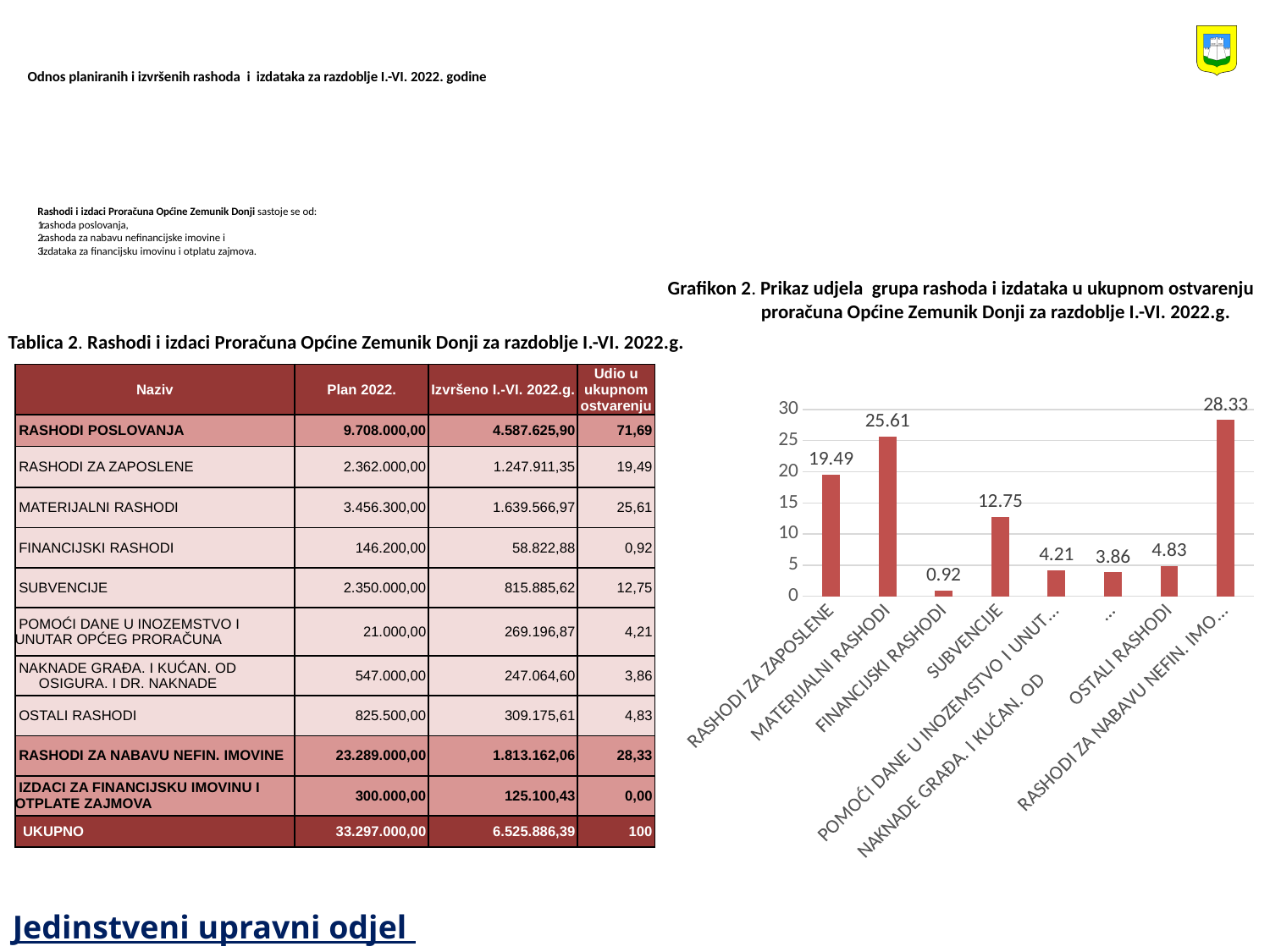
What is the value shown for MATERIJALNI RASHODI? 25.61 What is the difference between the values for MATERIJALNI RASHODI and RASHODI ZA ZAPOSLENE? 6.12 What is the value shown for RASHODI ZA ZAPOSLENE? 19.49 Which is larger, the value for SUBVENCIJE or the value for OSTALI RASHODI? SUBVENCIJE Is the value for SUBVENCIJE greater or less than 10? greater What is the value shown for OSTALI RASHODI? 4.83 What is the value shown for SUBVENCIJE? 12.75 Which category has the lowest value in the chart? FINANCIJSKI RASHODI What type of chart is shown on the slide? bar chart What is the value shown for FINANCIJSKI RASHODI? 0.92 What is the highest value labelled on any bar in the chart? 28.33 How many bars are plotted in the chart? 8